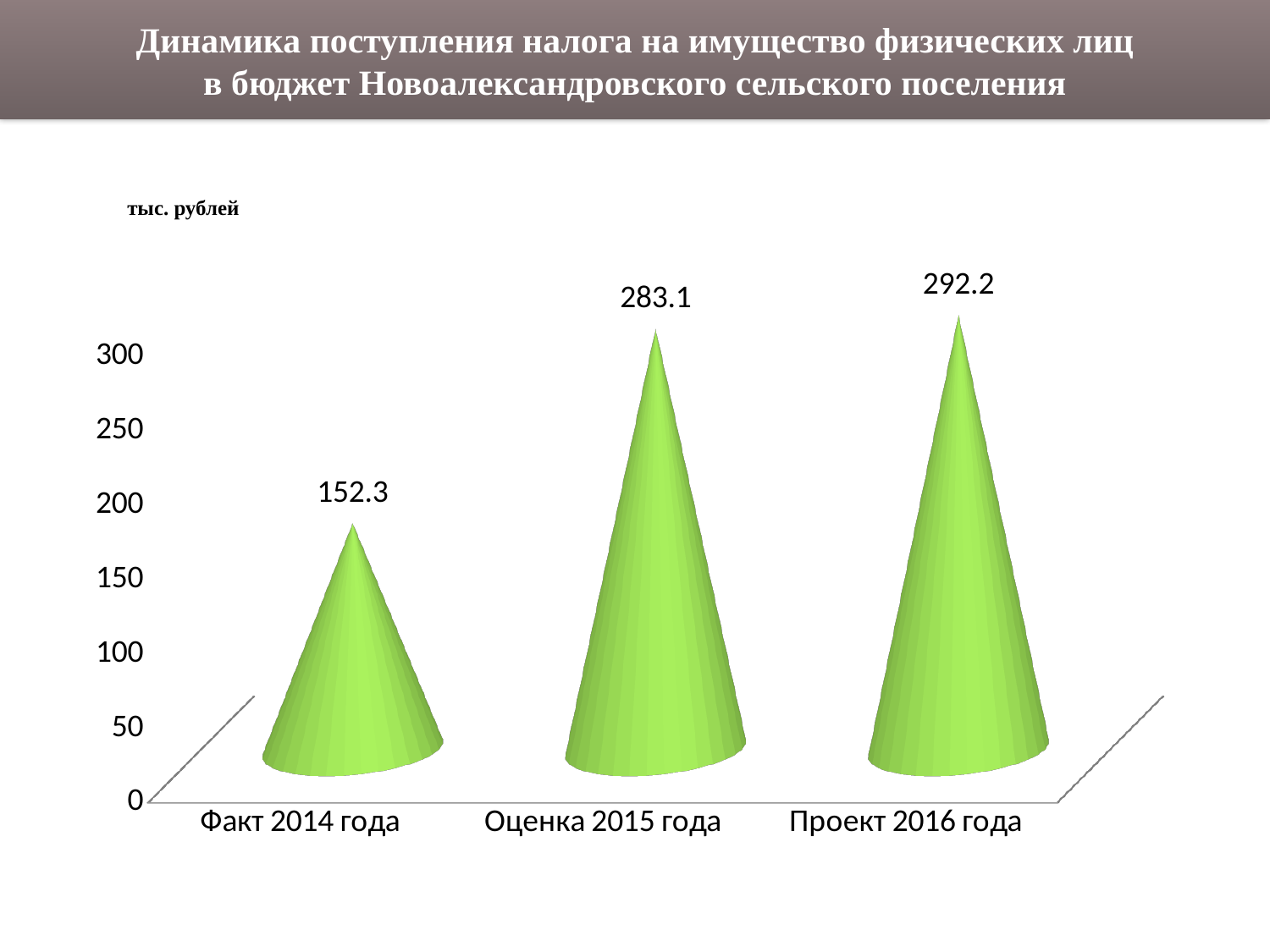
What is the value for Проект 2016 года? 292.2 What unit is stated for the values on the chart? тыс. рублей Which is larger, the value for Факт 2014 года or the value for Оценка 2015 года? Оценка 2015 года Do the values rise or fall from Факт 2014 года to Проект 2016 года? rise What is the difference between the values for Проект 2016 года and Оценка 2015 года? 9.1 What is the value for Оценка 2015 года? 283.1 How many categories are shown on the x axis? 3 Which category has the highest value? Проект 2016 года Which category has the lowest value? Факт 2014 года Is the value for Факт 2014 года greater or less than 200? less What is the difference between the values for Оценка 2015 года and Факт 2014 года? 130.8 What is the value for Факт 2014 года? 152.3